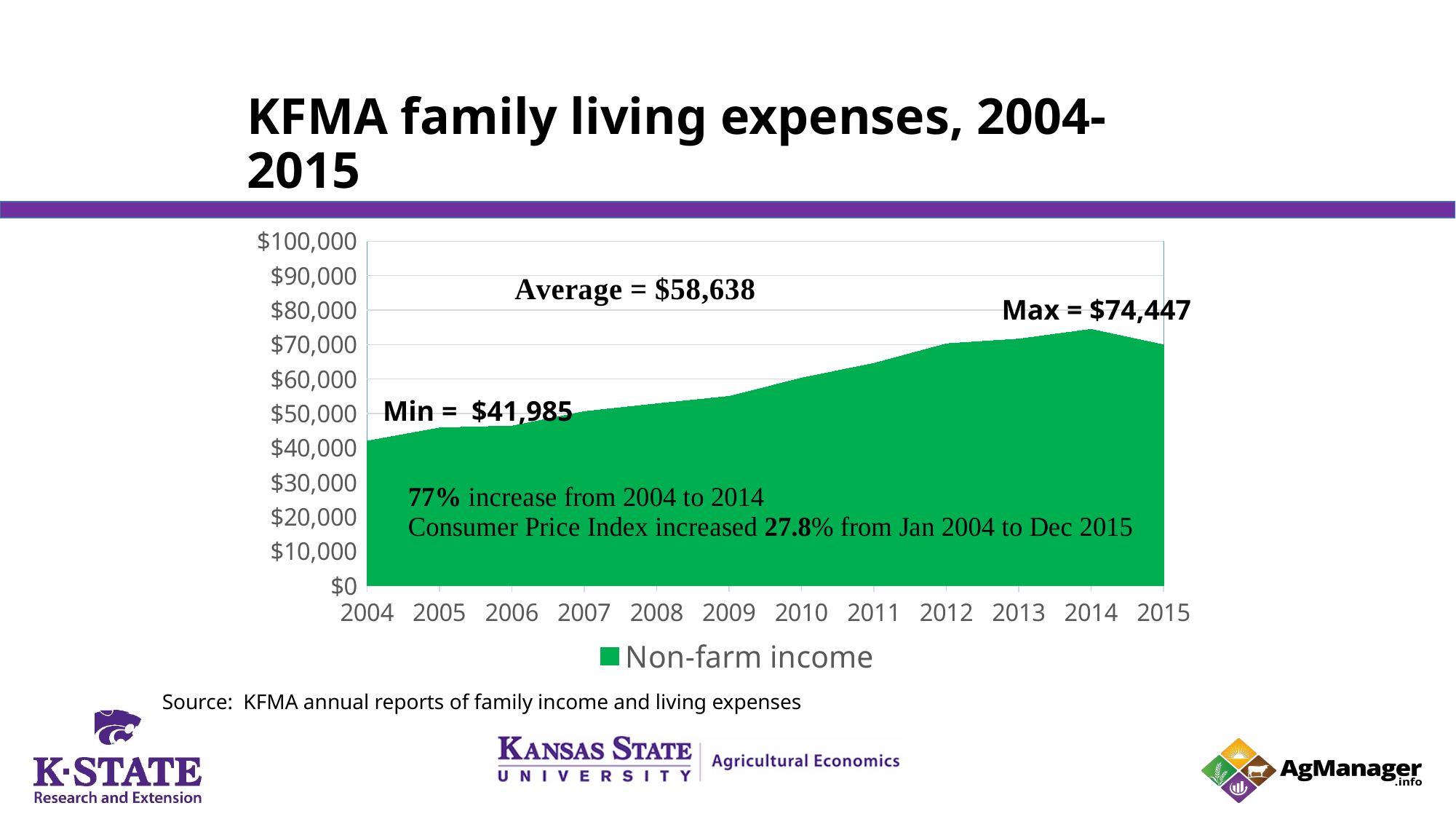
How many years are plotted along the x axis? 12 How many series does the legend list? 1 What kind of chart is shown on the slide? area chart What is the difference between the maximum and minimum values shown? $32,462 Which year has the lowest value? 2004 Is the value for 2009 greater or less than $60,000? less Which is larger, the value for 2012 or the value for 2008? 2012 What is the minimum value shown on the chart? $41,985 What is the maximum value shown on the chart? $74,447 What is the average value stated on the chart? $58,638 Which year has the highest value? 2014 Do the values generally rise or fall from 2004 to 2014? rise